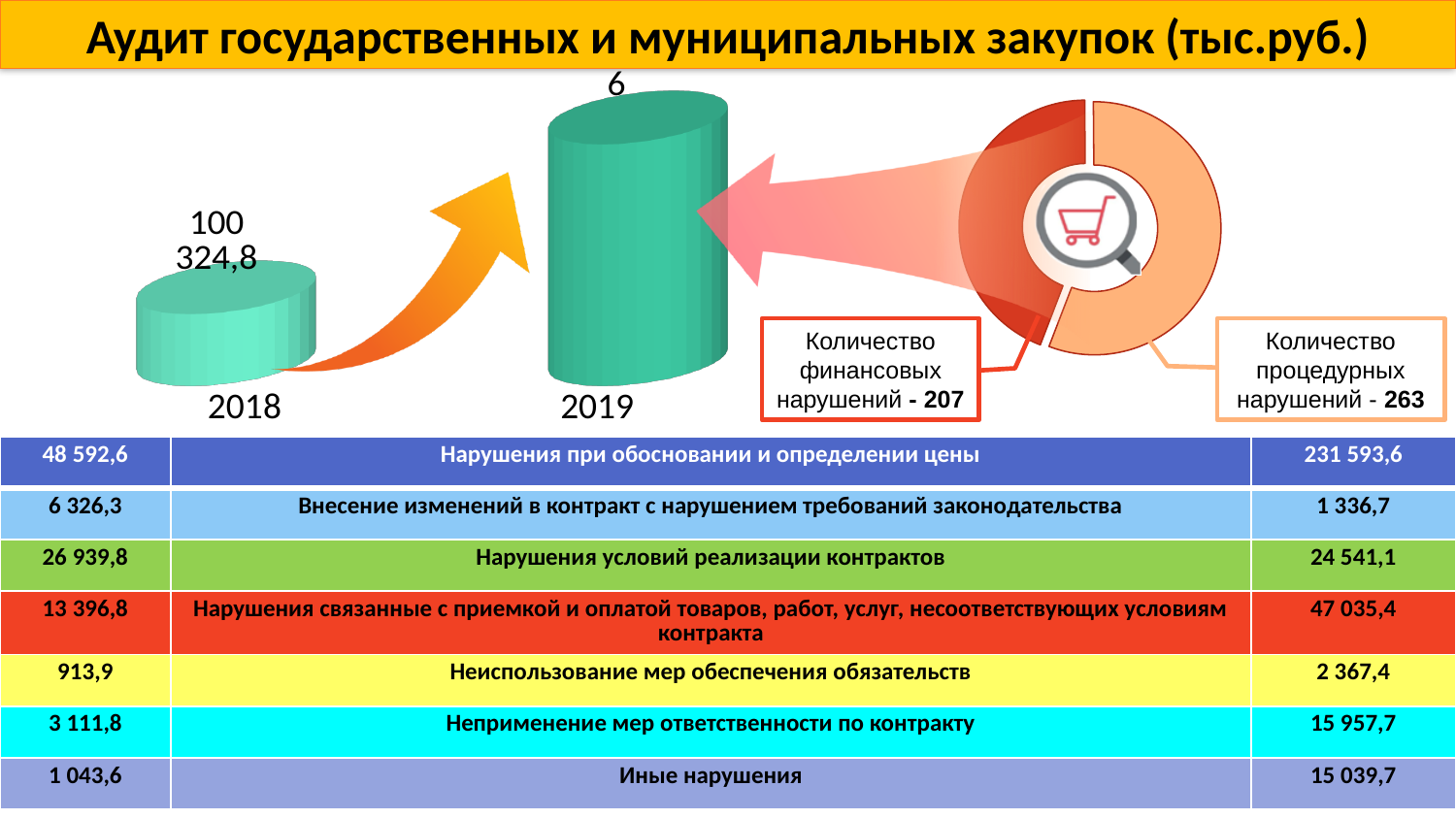
On the pie chart on the right, what is the total number of violations across both slices? 470 How many slices does the pie chart on the right have? 2 On the pie chart on the right, how many procedural violations (Количество процедурных нарушений) are shown? 263 On the pie chart on the right, what is the difference between the number of procedural violations and financial violations? 56 On the bar chart on the left, what value is shown for 2018? 100 324,8 What kind of chart is the chart on the left showing 2018 and 2019? bar chart On the pie chart on the right, which slice is larger: financial violations or procedural violations? procedural violations What is the title of the slide? Аудит государственных и муниципальных закупок (тыс.руб.) On the bar chart on the left, do the values rise or fall from 2018 to 2019? rise On the pie chart on the right, how many financial violations (Количество финансовых нарушений) are shown? 207 How many years (categories) are shown on the bar chart on the left? 2 On the bar chart on the left, which year has the taller bar, 2018 or 2019? 2019